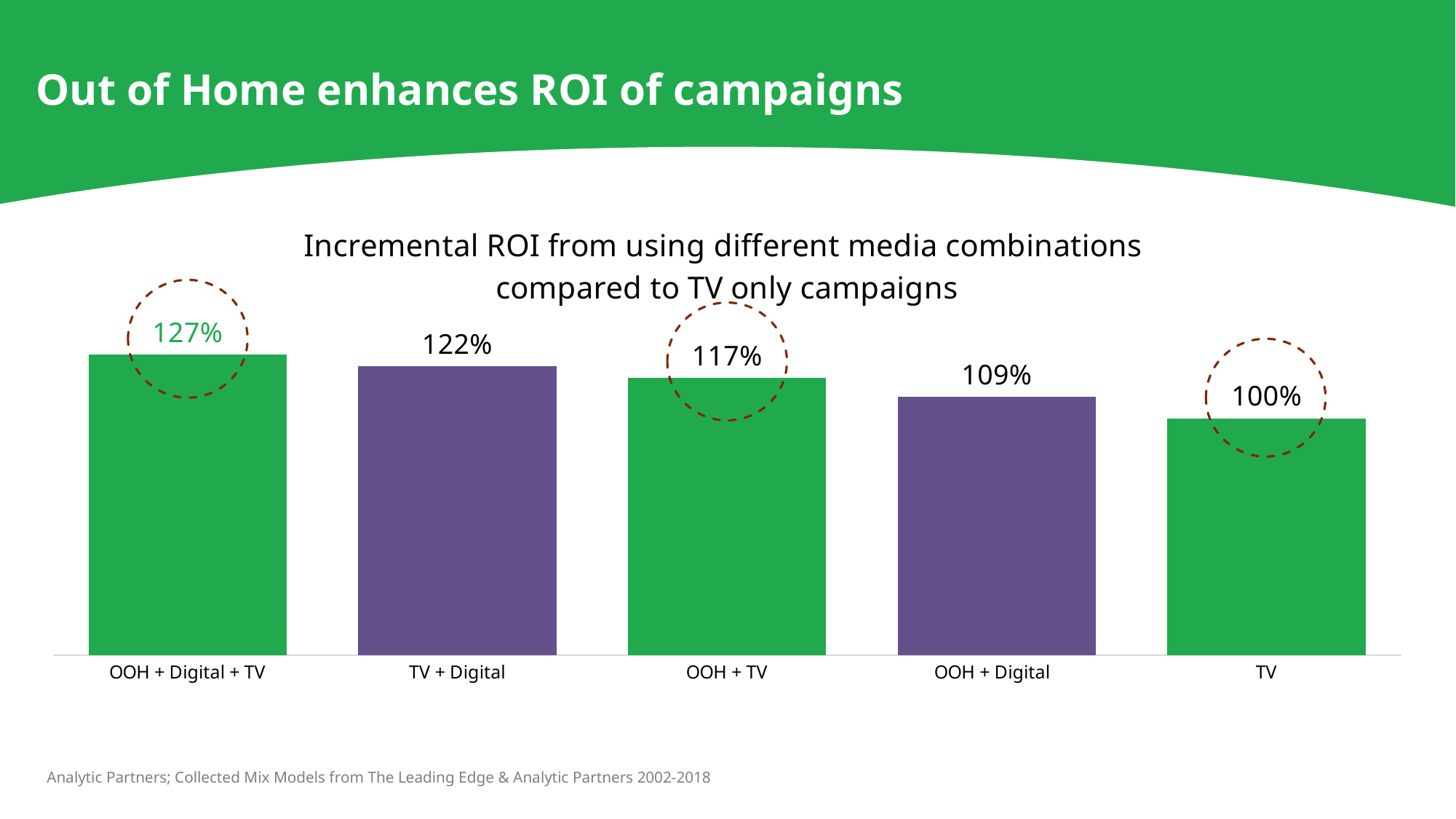
Which has a higher incremental ROI, OOH + TV or OOH + Digital? OOH + TV Which media combination has the highest incremental ROI? OOH + Digital + TV What is the incremental ROI value for TV? 100% What is the incremental ROI value for OOH + Digital + TV? 127% What is the difference in incremental ROI between OOH + Digital + TV and TV? 27% What kind of chart is shown on the slide? Bar chart What is the incremental ROI value for OOH + TV? 117% What is the incremental ROI value for OOH + Digital? 109% What is the difference in incremental ROI between TV + Digital and OOH + Digital? 13% How many media combinations are shown in the chart? 5 What is the incremental ROI value for TV + Digital? 122% Which media combination has the lowest incremental ROI? TV